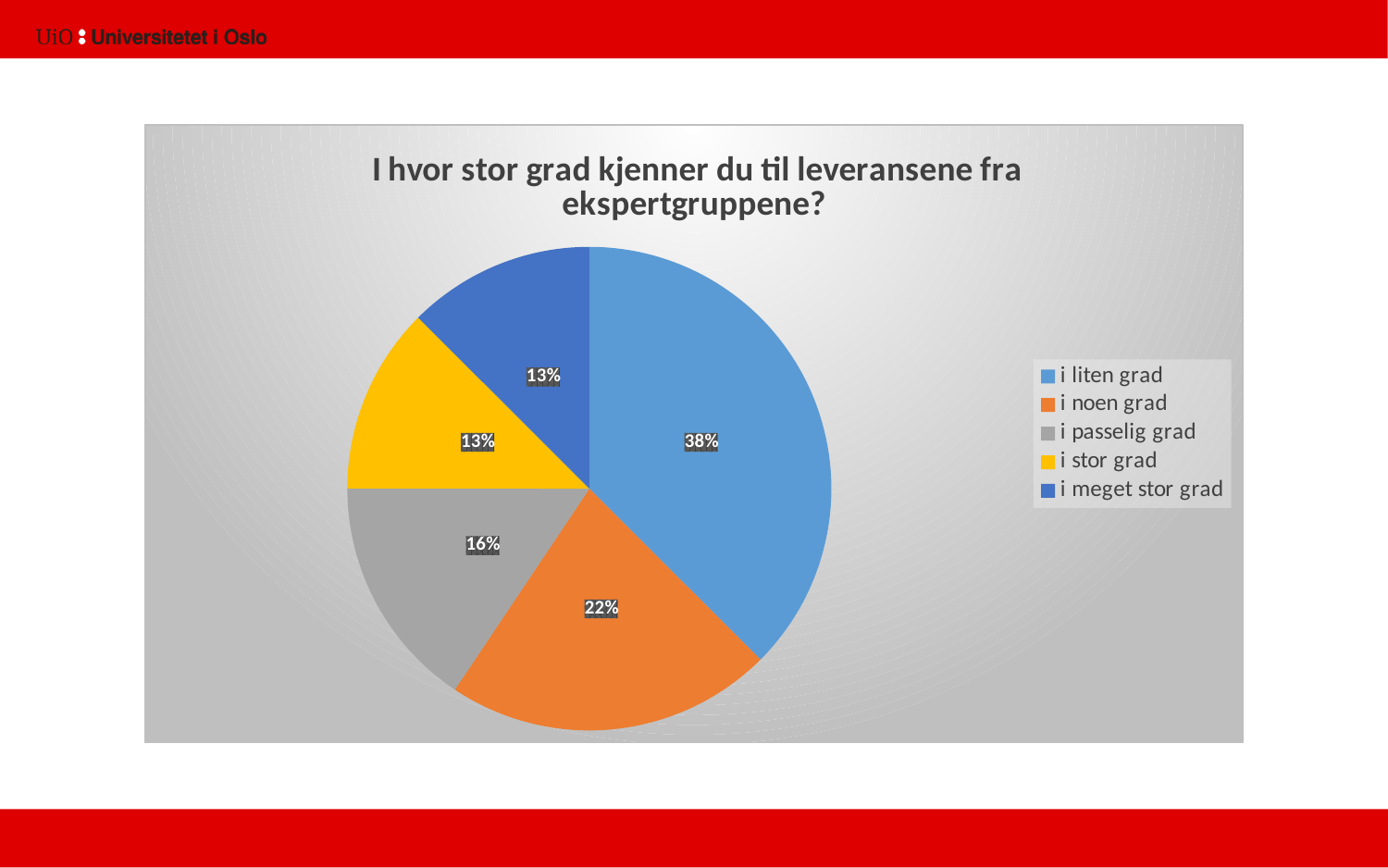
What kind of chart is shown on the slide? Pie chart Which is larger, the share for "i noen grad" or the share for "i passelig grad"? i noen grad What share of the pie is labelled for "i stor grad"? 13% What share of the pie is labelled for "i meget stor grad"? 13% What colour is the slice for "i stor grad"? Yellow Which category has the largest slice of the pie? i liten grad What share of the pie is labelled for "i passelig grad"? 16% How many categories does the legend list? 5 What is the title of the chart? I hvor stor grad kjenner du til leveransene fra ekspertgruppene? What is the difference in percentage points between "i liten grad" and "i noen grad"? 16